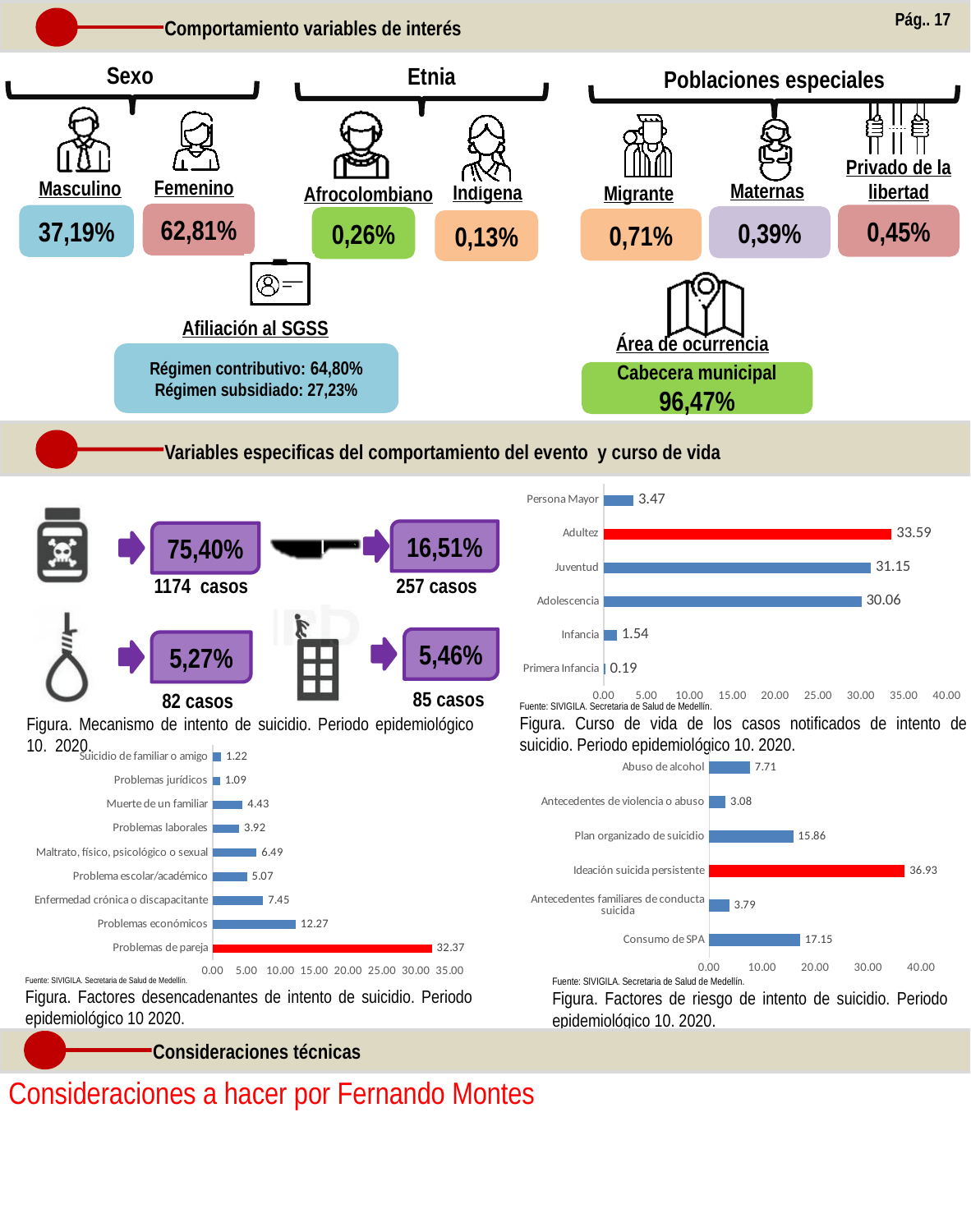
In the 'Factores de riesgo' chart, which category has the lowest value? Antecedentes de violencia o abuso In the 'Factores desencadenantes' chart, which category has the highest value? Problemas de pareja In the 'Factores de riesgo' chart, what is the value for Consumo de SPA? 17.15 In the 'Curso de vida' chart, what is the difference between Juventud and Adolescencia? 1.09 In the 'Curso de vida' chart, what is the value for Adultez? 33.59 In the 'Factores desencadenantes' chart, which is larger: Muerte de un familiar or Problemas laborales? Muerte de un familiar In the 'Factores desencadenantes' chart, how many categories are plotted? 9 In the 'Curso de vida' chart, which category has the lowest value? Primera Infancia In the 'Factores desencadenantes' chart, what is the value for Problemas económicos? 12.27 What type of chart is the 'Factores de riesgo' chart? Bar chart In the 'Curso de vida' chart, how many categories are plotted? 6 In the 'Factores de riesgo' chart, what is the difference between Ideación suicida persistente and Plan organizado de suicidio? 21.07